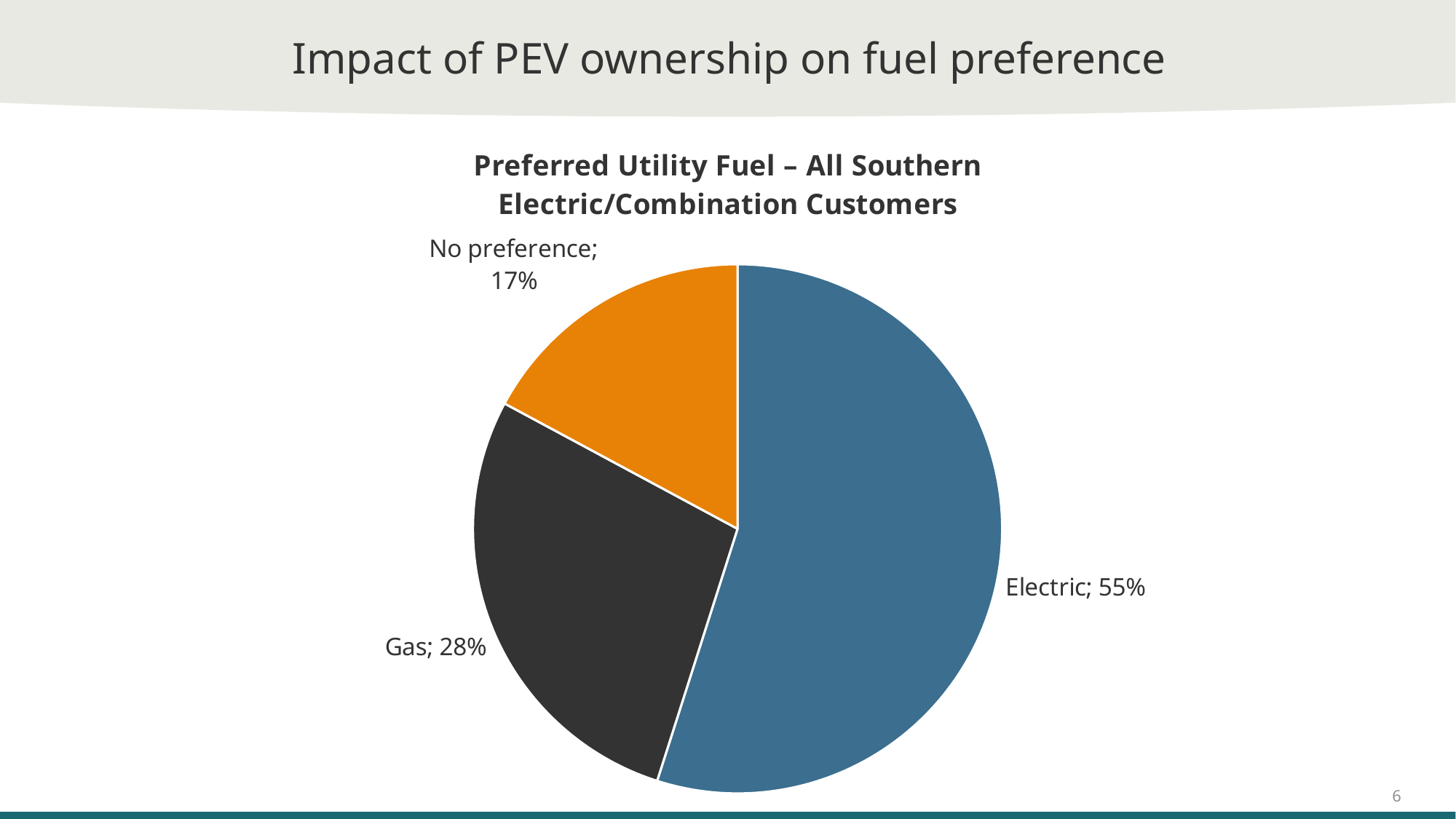
Which is larger, the Gas slice or the No preference slice? Gas What colour is the Electric slice? Blue What share of customers preferred Gas? 28% How many slices does the pie chart have? 3 What is the difference in percentage points between Electric and Gas? 27 What share of customers preferred Electric? 55% What kind of chart is shown on the slide? Pie chart What share of customers had No preference? 17% Which fuel preference has the largest slice? Electric What is the title of the chart? Preferred Utility Fuel – All Southern Electric/Combination Customers What is the difference in percentage points between Gas and No preference? 11 Which category has the smallest slice? No preference